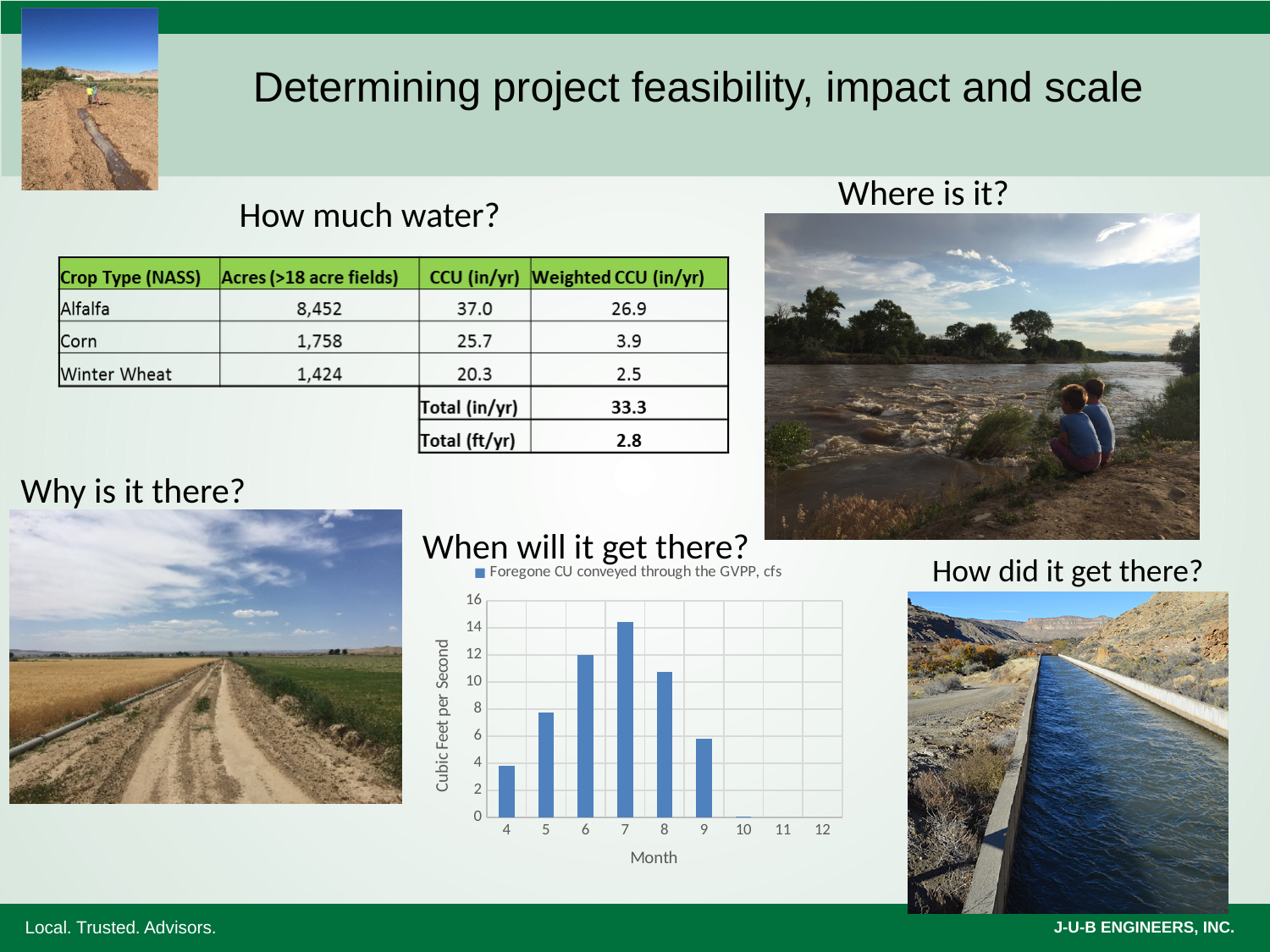
In the bar chart, do the values rise or fall from month 7 to month 10? fall In the bar chart, which month has the highest value? 7 In the bar chart, is the value for month 8 greater or less than 8? greater In the bar chart, is the value for month 9 greater or less than 4? greater How many series does the legend of the bar chart list? 1 In the bar chart, which is larger, the value for month 6 or month 8? month 6 In the bar chart, is the value for month 4 greater or less than 6? less In the bar chart, which is larger, the value for month 5 or month 9? month 5 What kind of chart is shown under "When will it get there?"? bar chart What is the y-axis title of the bar chart? Cubic Feet per Second In the bar chart, do the values rise or fall from month 4 to month 7? rise